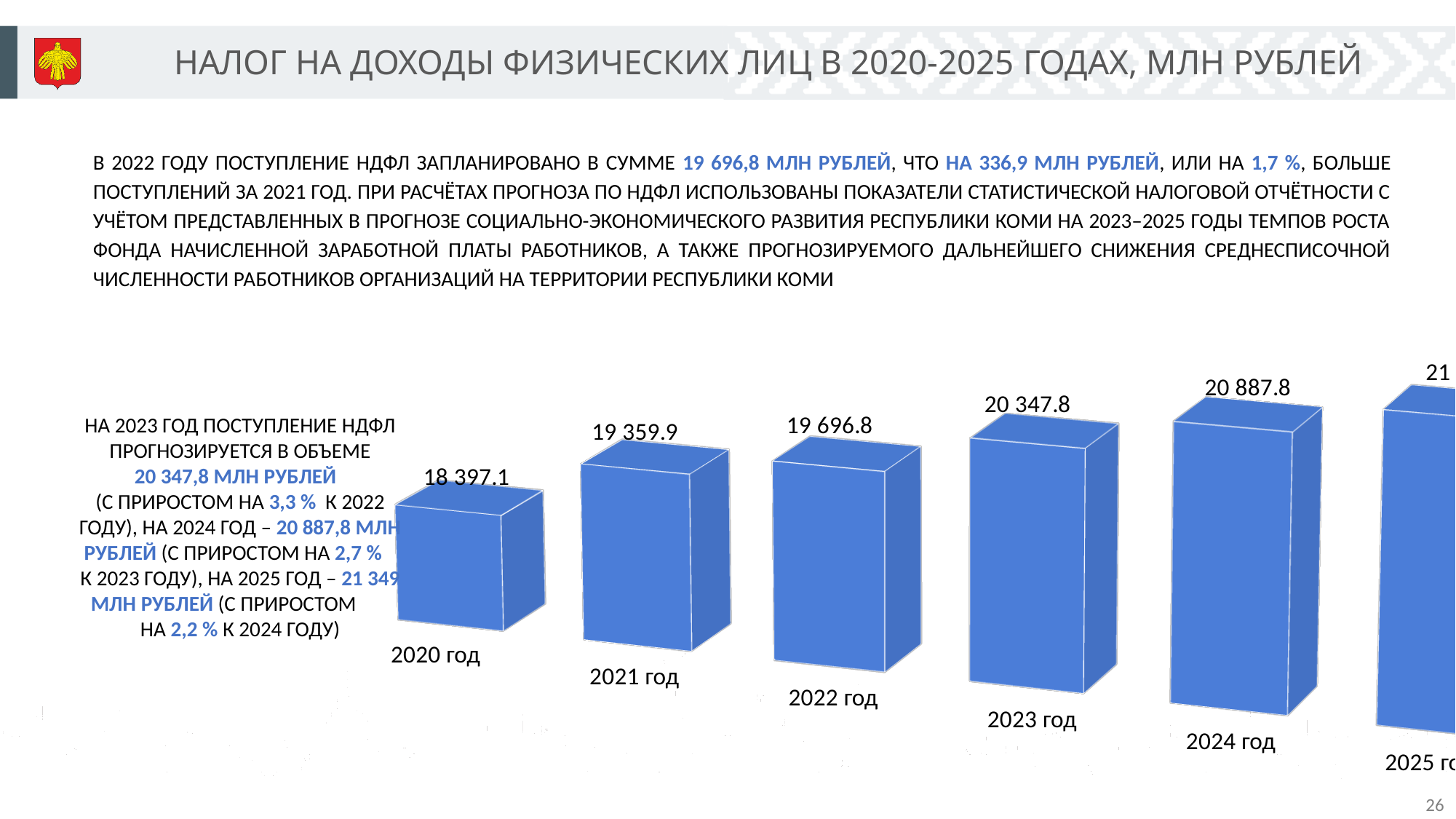
Which is larger, the value for 2023 год or the value for 2021 год? 2023 год What is the value for 2022 год? 19 696.8 What is the value for 2021 год? 19 359.9 What is the value for 2020 год? 18 397.1 What is the difference between the values for 2022 год and 2021 год? 336.9 What is the difference between the values for 2024 год and 2023 год? 540.0 How many years (bars) are shown on the chart? 6 What kind of chart is shown on the slide? bar chart Do the values rise or fall from 2020 to 2025? rise Which year has the lowest value on the chart? 2020 год What is the value for 2024 год? 20 887.8 What is the value for 2023 год? 20 347.8